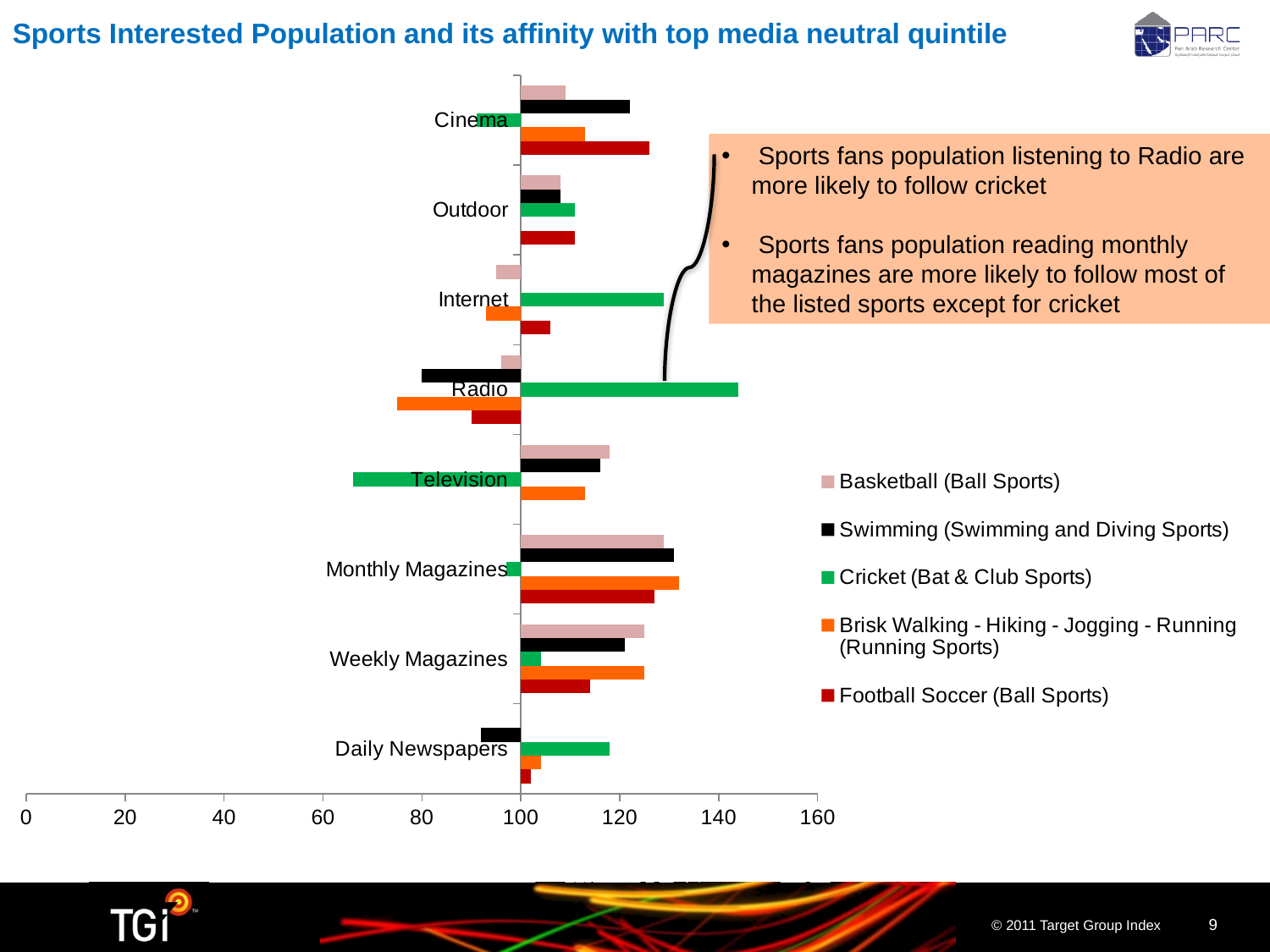
Which is larger: the Cricket (Bat & Club Sports) value for Internet or for Weekly Magazines? Internet What colour represents Cricket (Bat & Club Sports) in the legend? green Is the value for Cricket (Bat & Club Sports) for Television greater or less than 80? less Which media category has the highest value for Cricket (Bat & Club Sports)? Radio Is the value for Brisk Walking - Hiking - Jogging - Running (Running Sports) for Monthly Magazines greater or less than 120? greater How many series does the chart legend list? 5 How many media categories are plotted on the chart? 8 Which is larger: the Football Soccer (Ball Sports) value for Cinema or for Daily Newspapers? Cinema Is the value for Brisk Walking - Hiking - Jogging - Running (Running Sports) for Radio greater or less than 80? less What kind of chart is shown on the slide? bar chart Which media category has the lowest value for Cricket (Bat & Club Sports)? Television